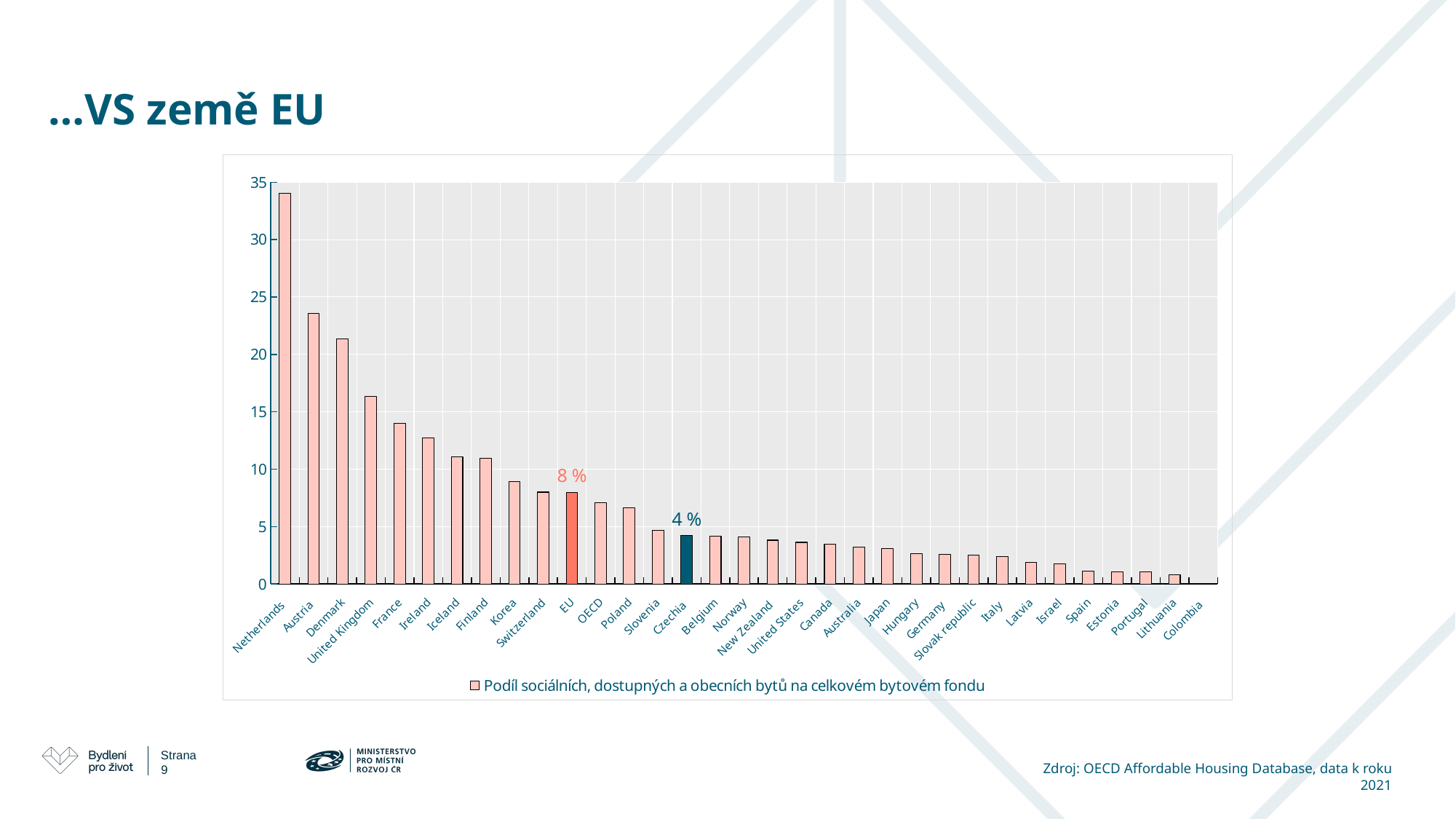
Do the values rise or fall from left to right along the x axis? fall Is the value for Belgium greater or less than 5? less What value is labelled for the EU bar? 8 % Is the value for Austria greater or less than 20? greater Which category has the lowest value in the chart? Colombia What value is labelled for Czechia? 4 % How many categories are shown on the x axis? 33 Is the value for Netherlands greater or less than 30? greater Which is larger, the value for the EU or the value for Czechia? EU Which country has the highest value in the chart? Netherlands What is the difference between the labelled values for the EU and Czechia? 4 % What type of chart is shown on the slide? bar chart